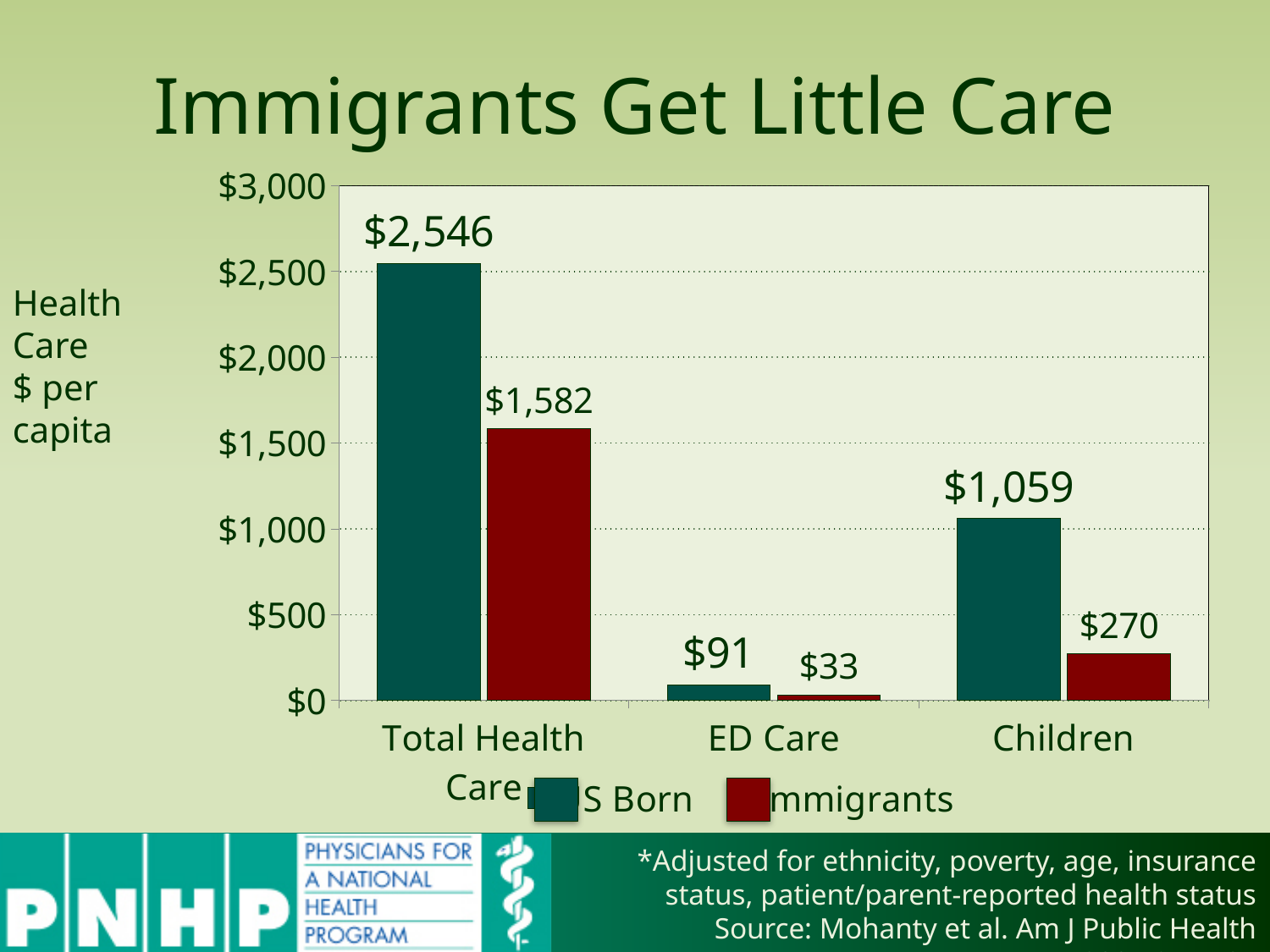
What is the difference between the US Born and Immigrants values in the Total Health Care category? $964 Is the value for Immigrants in the Total Health Care category greater or less than $1,500? greater Which is larger in the ED Care category, the US Born value or the Immigrants value? US Born How many series does the legend list? 2 What kind of chart is shown on the slide? bar chart Which category has the lowest value for Immigrants? ED Care How many categories are shown on the x axis? 3 What is the value for US Born in the Total Health Care category? $2,546 What is the value for Immigrants in the Children category? $270 What is the difference between the US Born and Immigrants values in the Children category? $789 What is the value for Immigrants in the ED Care category? $33 Which category has the highest value for US Born? Total Health Care